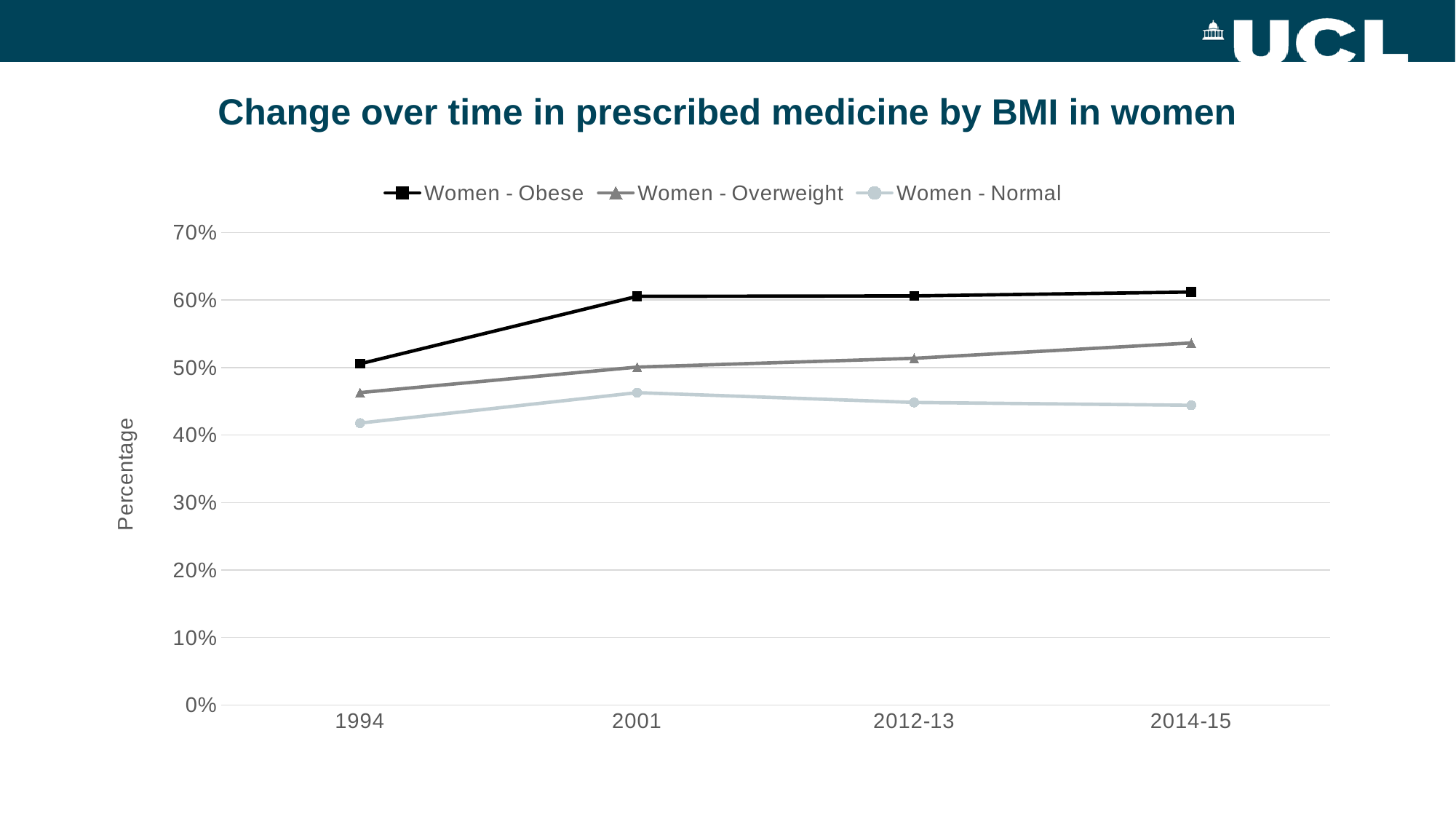
Does the Women - Obese line rise or fall between 1994 and 2001? Rise Is the value for Women - Normal in 1994 greater or less than 40%? greater How many series does the legend list? 3 Is the value for Women - Obese in 2001 greater or less than 50%? greater What is the label on the y axis? Percentage What kind of chart is shown on the slide? Line chart Is the value for Women - Overweight in 2014-15 greater or less than 50%? greater In 2001, which is larger: Women - Obese or Women - Overweight? Women - Obese Which series has the lowest value in 2014-15? Women - Normal How many time points are plotted along the x axis? 4 Which series has the highest value in 2014-15? Women - Obese